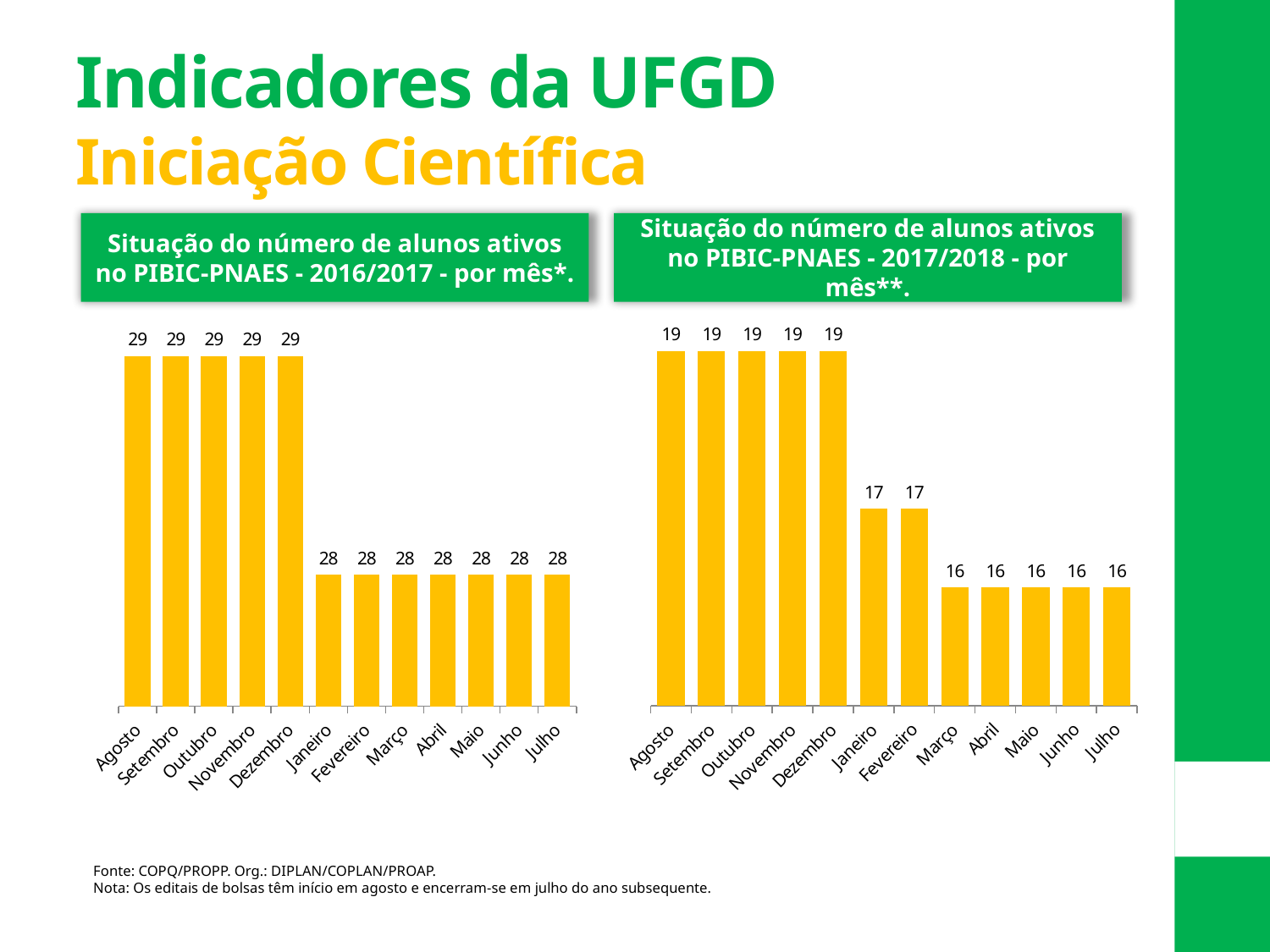
What kind of chart is the 2016/2017 chart (left)? Bar chart What is the title of the chart on the left? Situação do número de alunos ativos no PIBIC-PNAES - 2016/2017 - por mês*. How many months (categories) are shown in the 2017/2018 chart (right)? 12 In the 2017/2018 chart (right), do the values rise or fall from Agosto to Julho? Fall In the 2017/2018 chart (right), what is the value for Janeiro? 17 In the 2017/2018 chart (right), which is larger, the value for Fevereiro or the value for Março? Fevereiro In the 2016/2017 chart (left), what is the difference between the value for Dezembro and the value for Janeiro? 1 In the 2016/2017 chart (left), what is the value for Agosto? 29 In the 2017/2018 chart (right), what is the difference between the value for Agosto and the value for Julho? 3 In the 2017/2018 chart (right), what is the value for Julho? 16 In the 2016/2017 chart (left), what is the value for Março? 28 In the 2016/2017 chart (left), which is larger, the value for Outubro or the value for Abril? Outubro